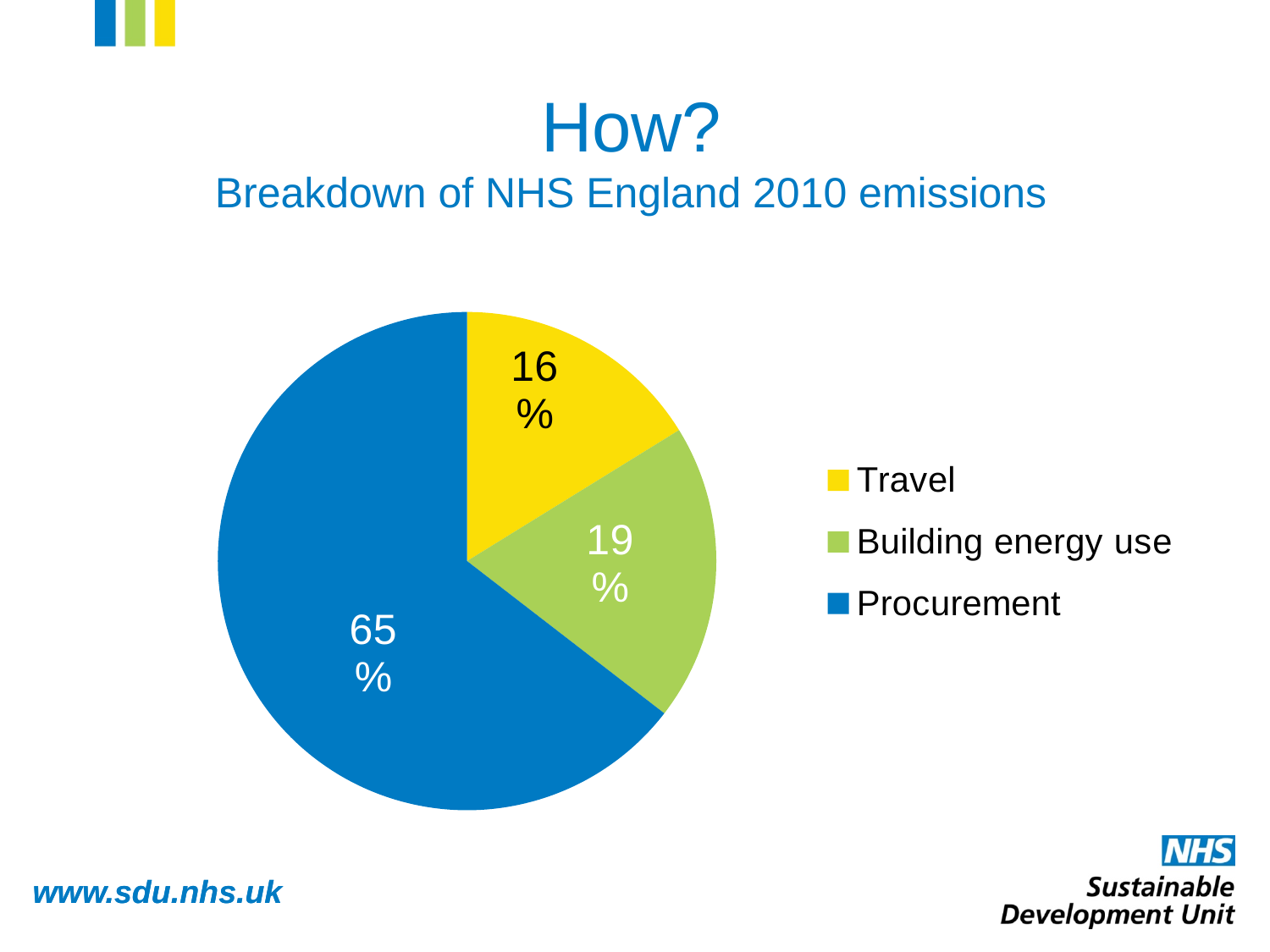
What share of NHS England 2010 emissions comes from Travel? 16% What share of NHS England 2010 emissions comes from Procurement? 65% Which is larger, the share for Travel or the share for Procurement? Procurement What share of NHS England 2010 emissions comes from Building energy use? 19% Which colour represents Building energy use in the pie chart? Green Which category accounts for the smallest share of emissions? Travel What kind of chart is shown on the slide? Pie chart How many percentage points larger is the Procurement share than the Building energy use share? 46 Which category accounts for the largest share of emissions? Procurement How many percentage points larger is the Building energy use share than the Travel share? 3 How many categories does the pie chart show? 3 What is the title of the chart? Breakdown of NHS England 2010 emissions